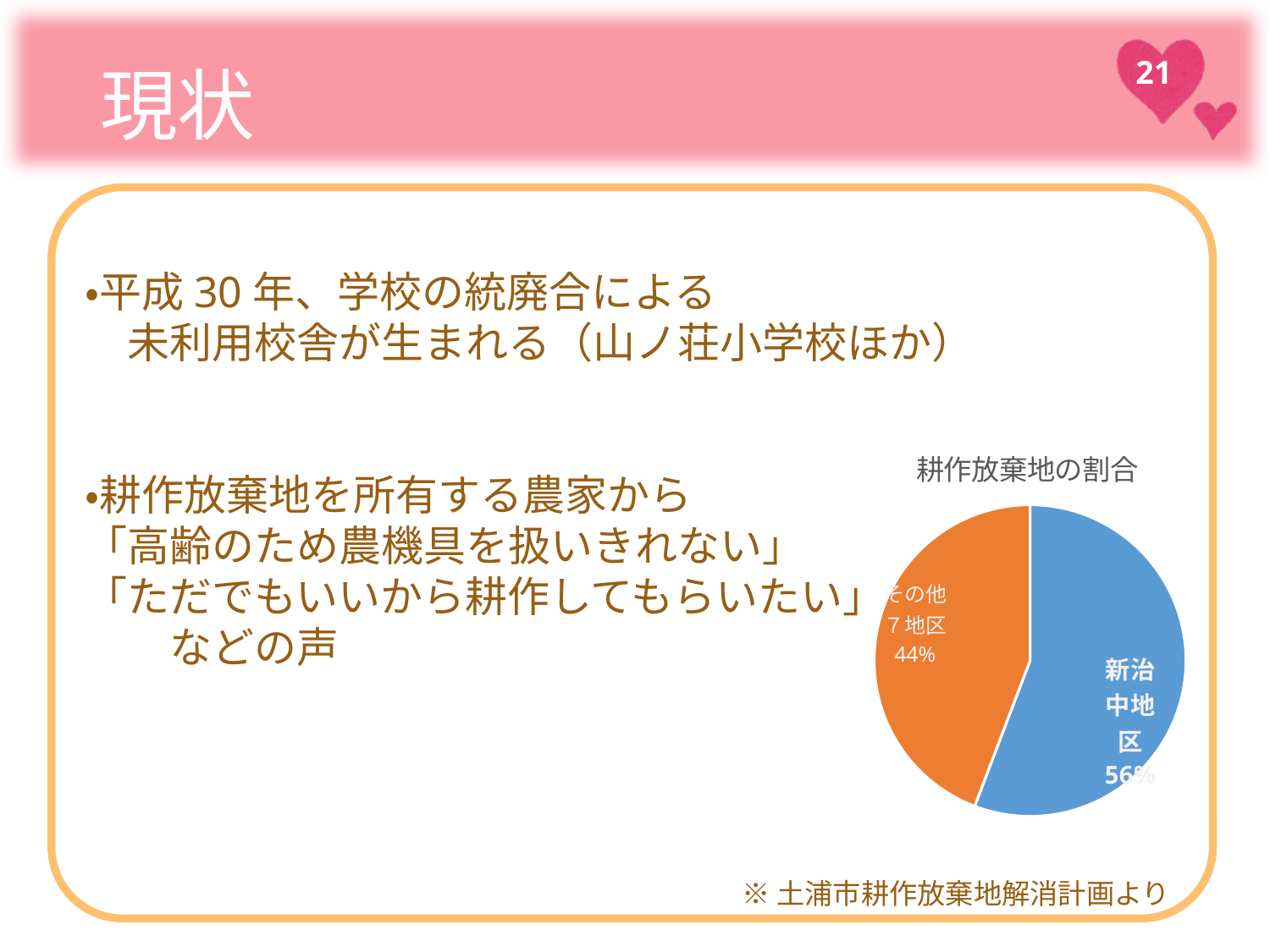
Which is larger, the share for 新治中地区 or the share for その他7地区? 新治中地区 Is the share for 新治中地区 greater or less than 50%? greater Which slice of the pie is the smallest? その他7地区 What kind of chart is shown on the slide? pie chart What is the title of the chart on the slide? 耕作放棄地の割合 How many slices does the pie chart have? 2 Which slice of the pie is the largest? 新治中地区 What share of the pie does 新治中地区 hold? 56% What is the difference in percentage points between the 新治中地区 slice and the その他7地区 slice? 12 What colour is the 新治中地区 slice of the pie? blue What share of the pie does その他7地区 hold? 44%